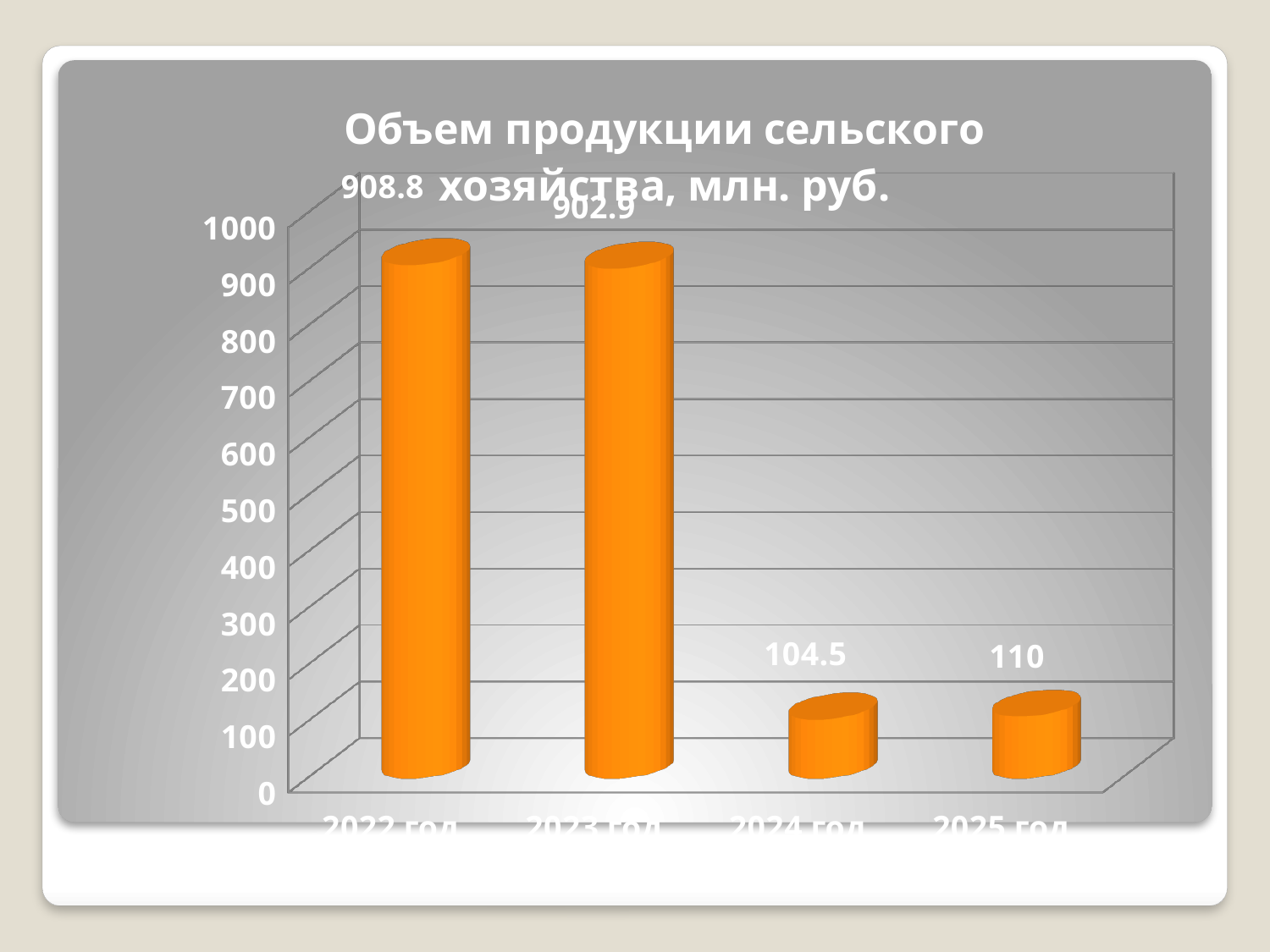
What is the difference between the values for 2025 год and 2024 год? 5.5 What is the value for 2024 год? 104.5 Which year has the lowest value? 2024 год How many years are shown on the x axis? 4 Which is larger, the value for 2023 год or the value for 2025 год? 2023 год Which year has the highest value? 2022 год What is the value for 2022 год? 908.8 What is the title of the chart? Объем продукции сельского хозяйства, млн. руб. Is the value for 2023 год greater or less than 800? greater What is the value for 2025 год? 110 What kind of chart is shown on the slide? bar chart What is the difference between the values for 2022 год and 2023 год? 5.9